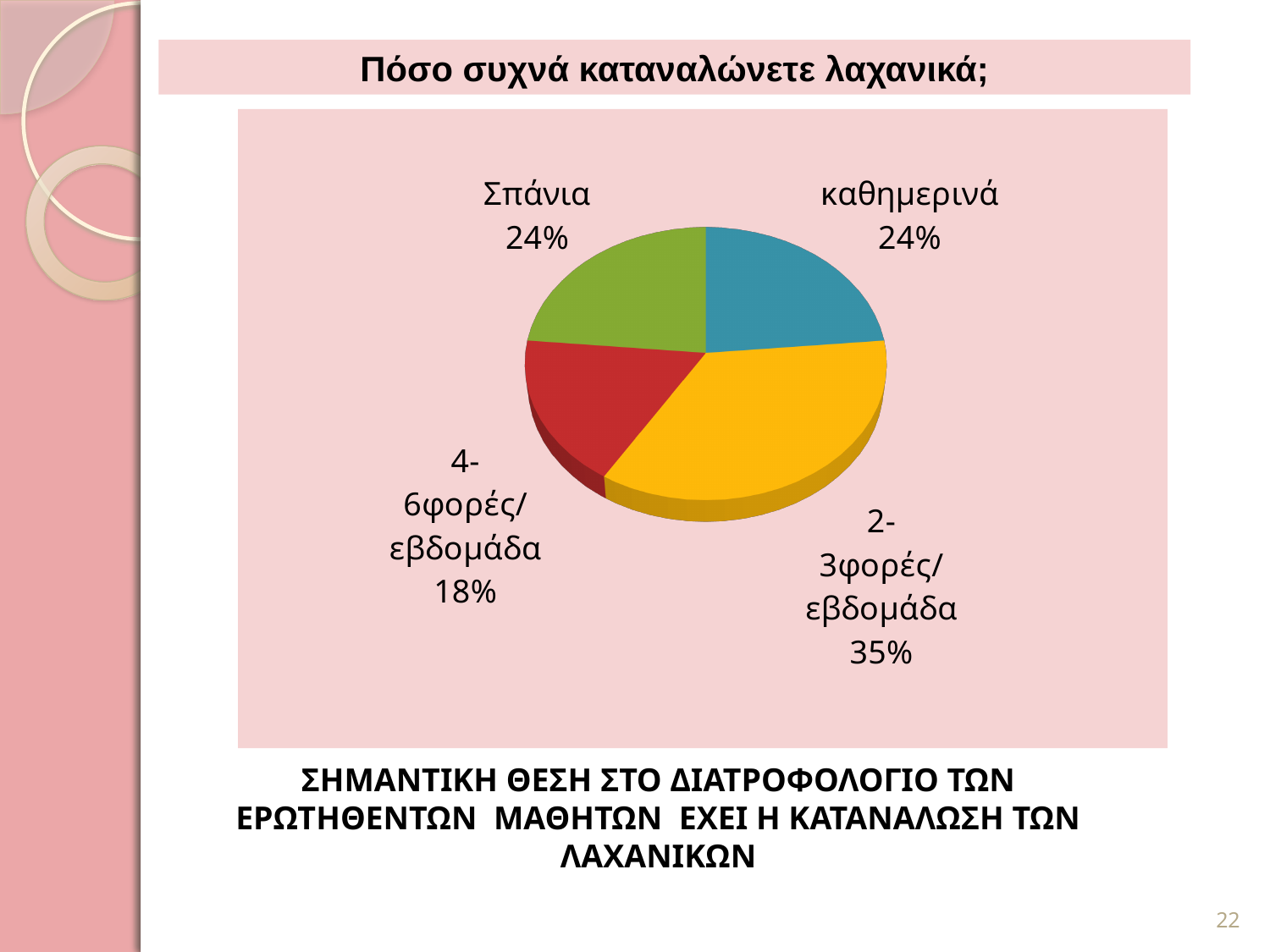
What is the title of the chart? Πόσο συχνά καταναλώνετε λαχανικά; Which category has the largest slice of the pie? 2-3φορές/εβδομάδα What share of the pie does the 'Σπάνια' slice represent? 24% How many categories are shown in the pie chart? 4 What colour is the '2-3φορές/εβδομάδα' slice? Yellow What kind of chart is shown on the slide? Pie chart Which is larger: the 'Σπάνια' slice or the '4-6φορές/εβδομάδα' slice? Σπάνια What share of the pie does the '4-6φορές/εβδομάδα' slice represent? 18% What share of the pie does the '2-3φορές/εβδομάδα' slice represent? 35% What is the difference in percentage points between the '2-3φορές/εβδομάδα' slice and the '4-6φορές/εβδομάδα' slice? 17% Which category has the smallest slice of the pie? 4-6φορές/εβδομάδα